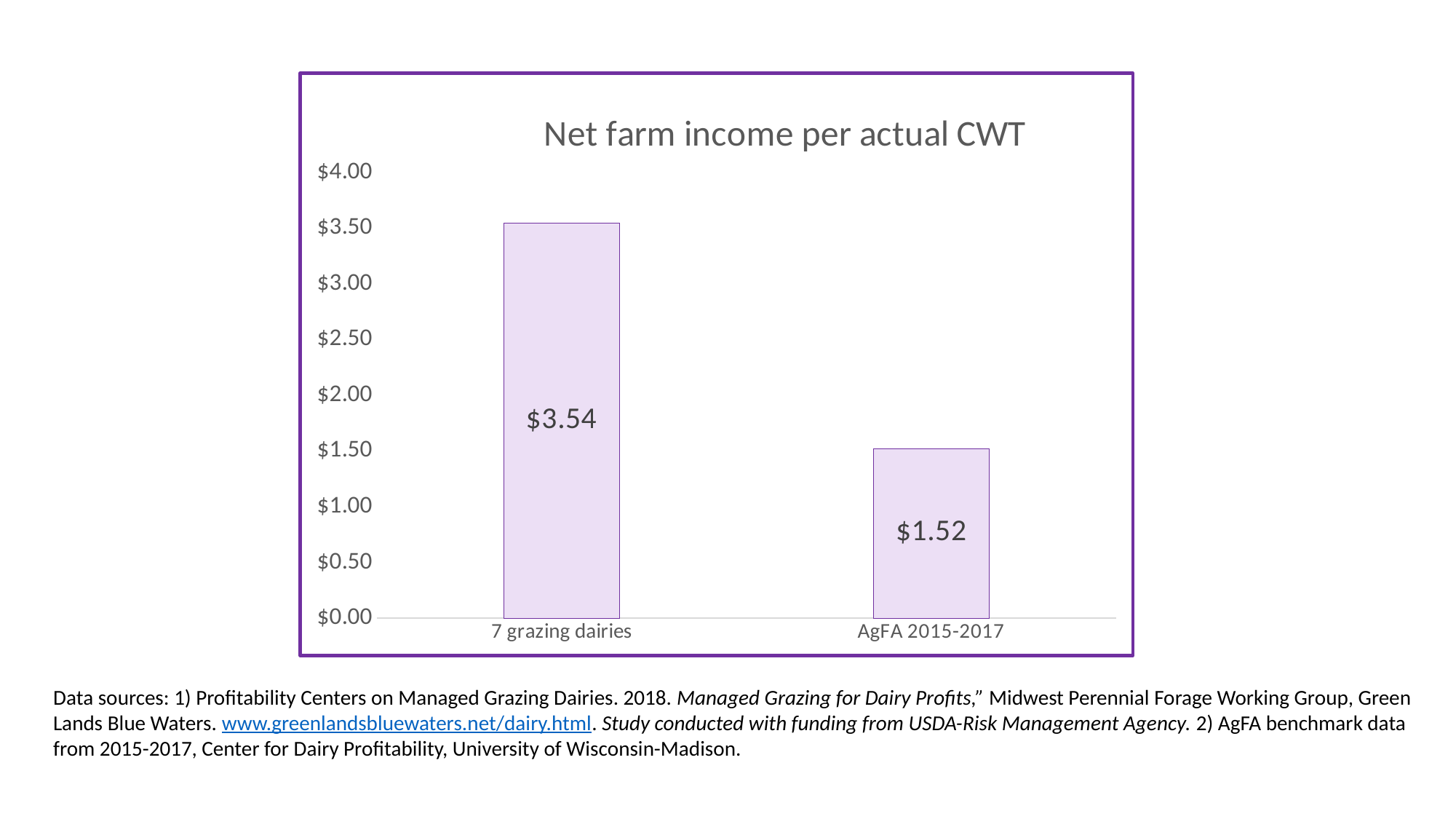
Is the value for 7 grazing dairies greater or less than $3.00? greater Which category has the higher net farm income per actual CWT? 7 grazing dairies Which category has the lower net farm income per actual CWT? AgFA 2015-2017 What is the highest value shown on the vertical axis of the chart? $4.00 What is the net farm income per actual CWT for AgFA 2015-2017? $1.52 Is the net farm income per actual CWT larger for the 7 grazing dairies or for AgFA 2015-2017? 7 grazing dairies What is the difference in net farm income per actual CWT between the 7 grazing dairies and AgFA 2015-2017? $2.02 What is the title of the chart? Net farm income per actual CWT What kind of chart is shown on the slide? Bar chart How many categories are shown on the chart? 2 Is the value for AgFA 2015-2017 greater or less than $2.00? less What is the net farm income per actual CWT for the 7 grazing dairies? $3.54